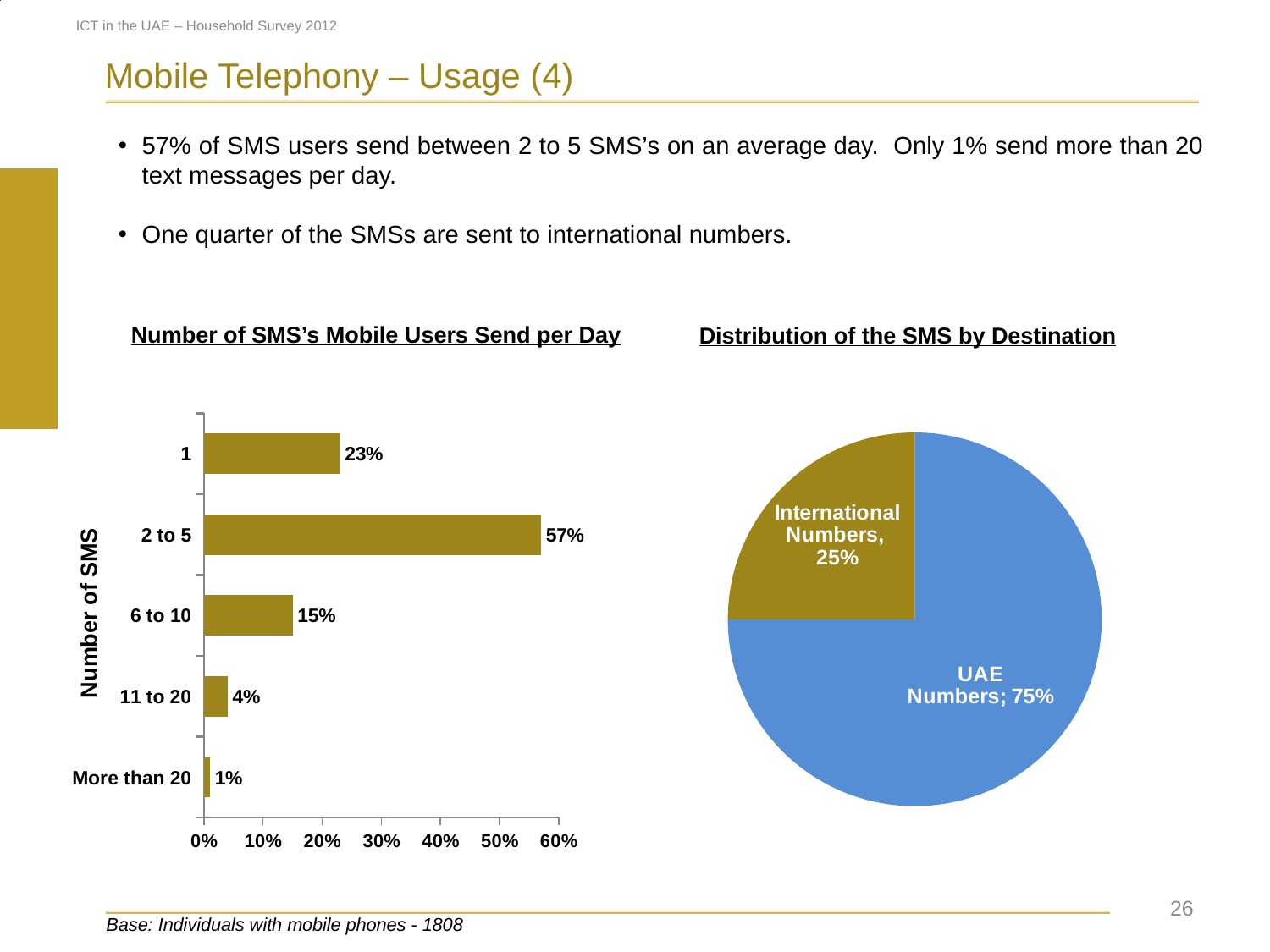
In the 'Number of SMS's Mobile Users Send per Day' chart, which is larger: the value for '1' or the value for '6 to 10'? 1 In the 'Number of SMS's Mobile Users Send per Day' chart, what is the difference between the values for '2 to 5' and '1'? 34% In the 'Number of SMS's Mobile Users Send per Day' chart, what is the label of the vertical axis? Number of SMS In the 'Distribution of the SMS by Destination' chart, what share of SMS goes to UAE Numbers? 75% What type of chart is 'Number of SMS's Mobile Users Send per Day'? Bar chart In the 'Number of SMS's Mobile Users Send per Day' chart, which category has the lowest value? More than 20 In the 'Number of SMS's Mobile Users Send per Day' chart, how many categories are shown? 5 In the 'Number of SMS's Mobile Users Send per Day' chart, which category has the highest value? 2 to 5 What type of chart is 'Distribution of the SMS by Destination'? Pie chart In the 'Distribution of the SMS by Destination' chart, what share of SMS goes to International Numbers? 25% In the 'Number of SMS's Mobile Users Send per Day' chart, what is the value for '6 to 10'? 15% In the 'Number of SMS's Mobile Users Send per Day' chart, what percentage of users send 2 to 5 SMS per day? 57%